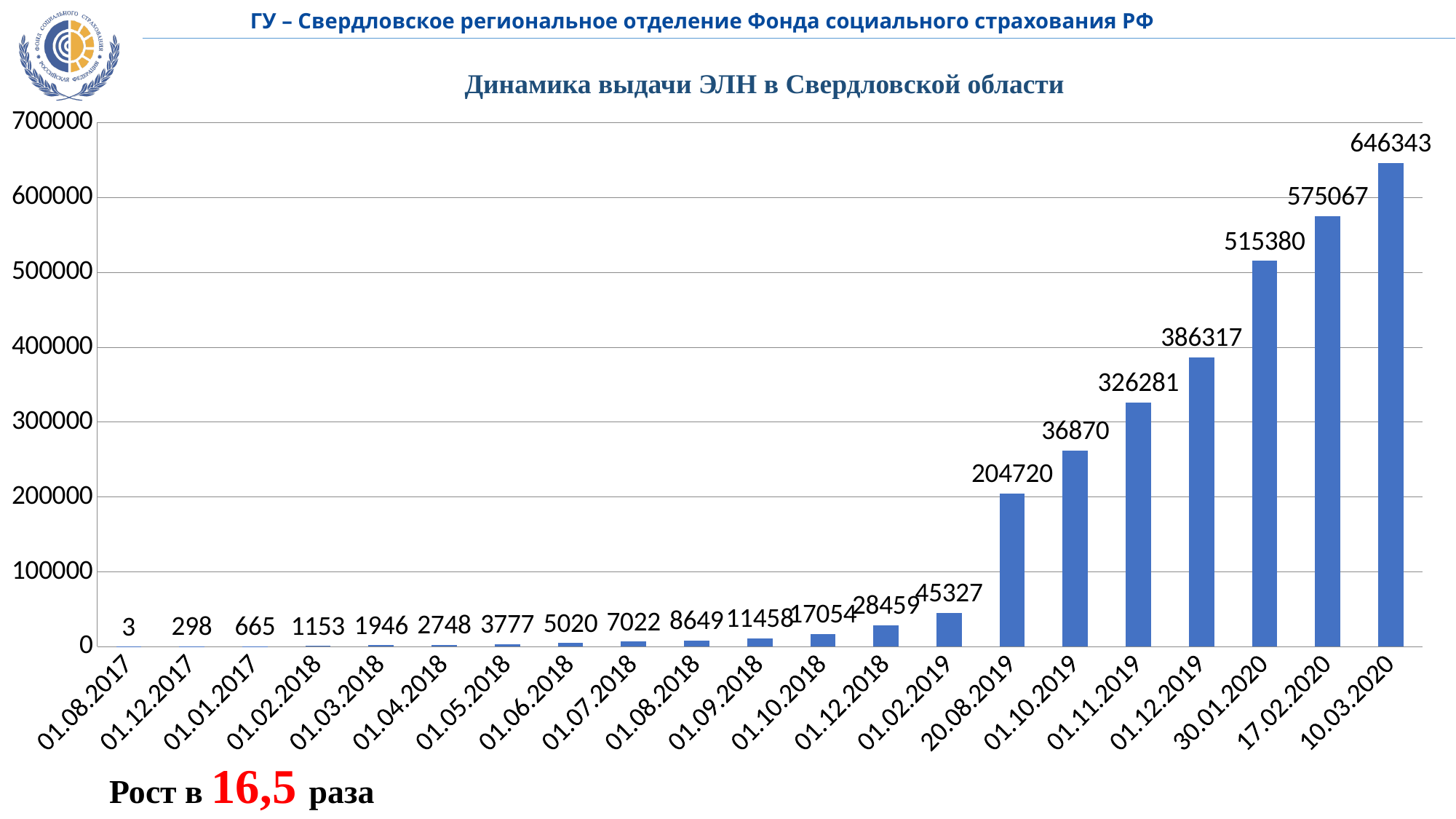
What is the value for 10.03.2020? 646343 Which date has the highest value? 10.03.2020 What is the value for 20.08.2019? 204720 What is the value for 01.06.2018? 5020 How many dates are shown on the x axis? 21 Which is larger, the value for 01.12.2019 or the value for 01.11.2019? 01.12.2019 Is the value for 30.01.2020 greater or less than 500000? greater What kind of chart is this? bar chart Do the values rise or fall from left to right along the x axis? rise Which date has the lowest value? 01.08.2017 What is the difference between the values for 10.03.2020 and 17.02.2020? 71276 What is the value for 01.02.2019? 45327